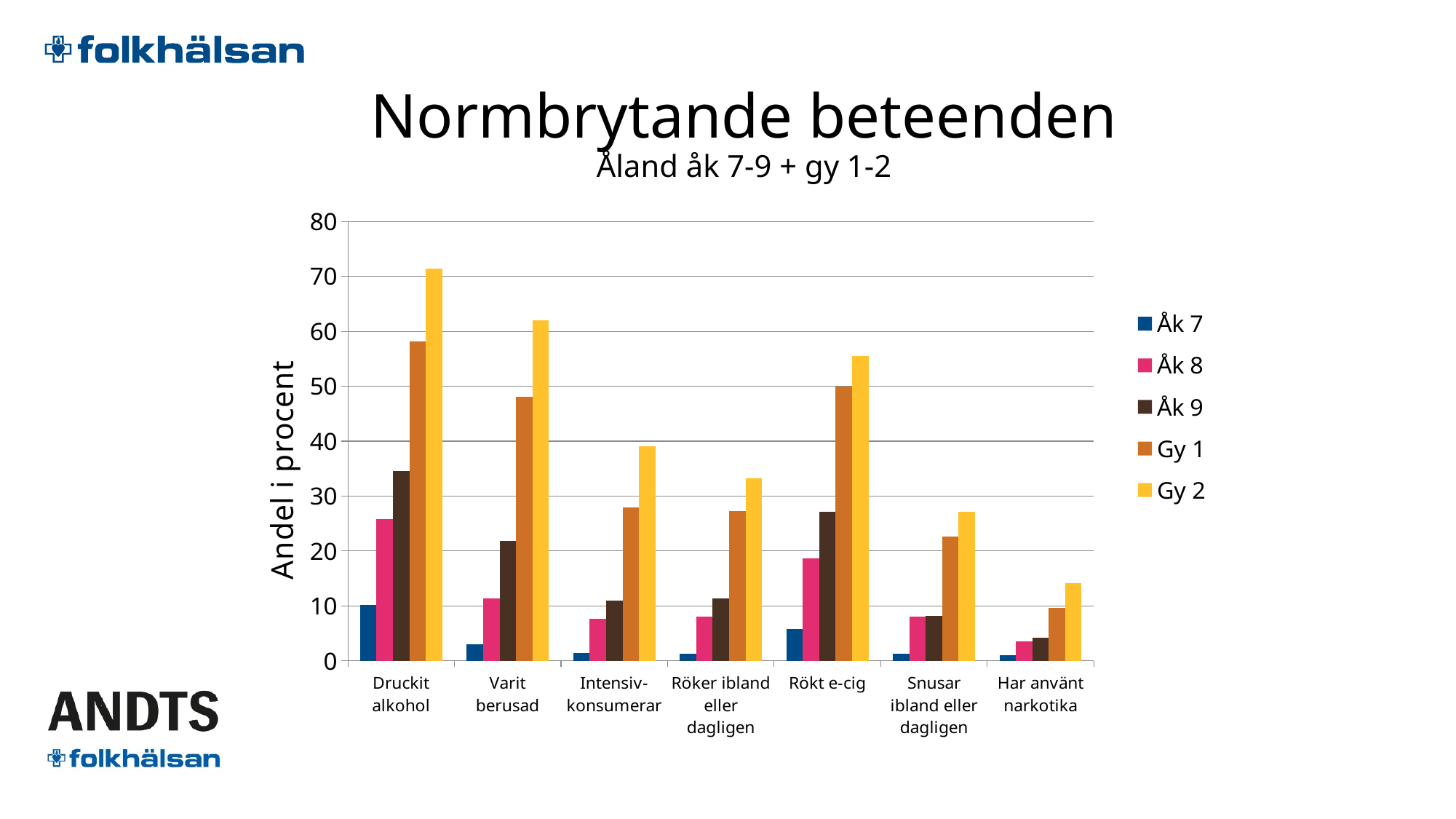
What is the label on the y axis? Andel i procent For Druckit alkohol, which is larger: the Åk 8 value or the Åk 9 value? Åk 9 Is the Gy 2 value for Intensivkonsumerar greater or less than 30? greater Is the Åk 7 value for Druckit alkohol greater or less than 20? less What kind of chart is shown on the slide? bar chart How many categories are shown on the x axis? 7 For Rökt e-cig, which is larger: the Gy 1 value or the Gy 2 value? Gy 2 Is the Gy 1 value for Varit berusad greater or less than 40? greater Which category has the highest Gy 2 bar? Druckit alkohol Which category has the lowest Gy 2 bar? Har använt narkotika How many series does the legend list? 5